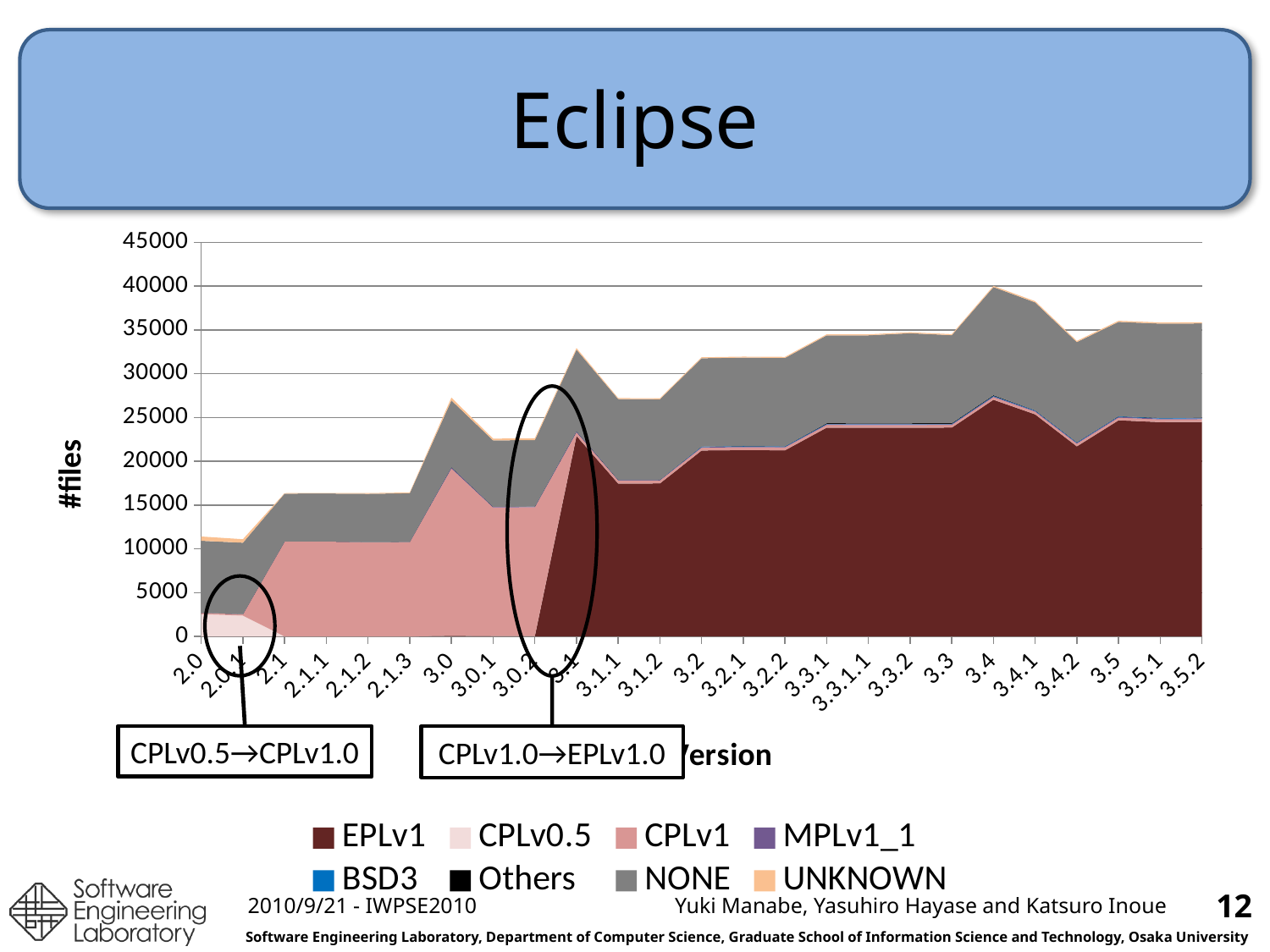
What is the title of the slide containing the chart? Eclipse Is the total number of files for version 3.0 greater or less than 25000? greater Does the total number of files generally rise or fall from version 2.0 to version 3.5.2? rise Which series accounts for the largest number of files at version 3.5.2? EPLv1 Which has a larger total number of files, version 3.4 or version 3.4.2? 3.4 What is the label on the vertical axis of the chart? #files How many series does the legend list? 8 Is the total number of files for version 3.1 greater or less than 30000? greater Is the total number of files for version 2.1 greater or less than 20000? less What kind of chart is shown on the slide? stacked area chart Which version has the highest total number of files? 3.4